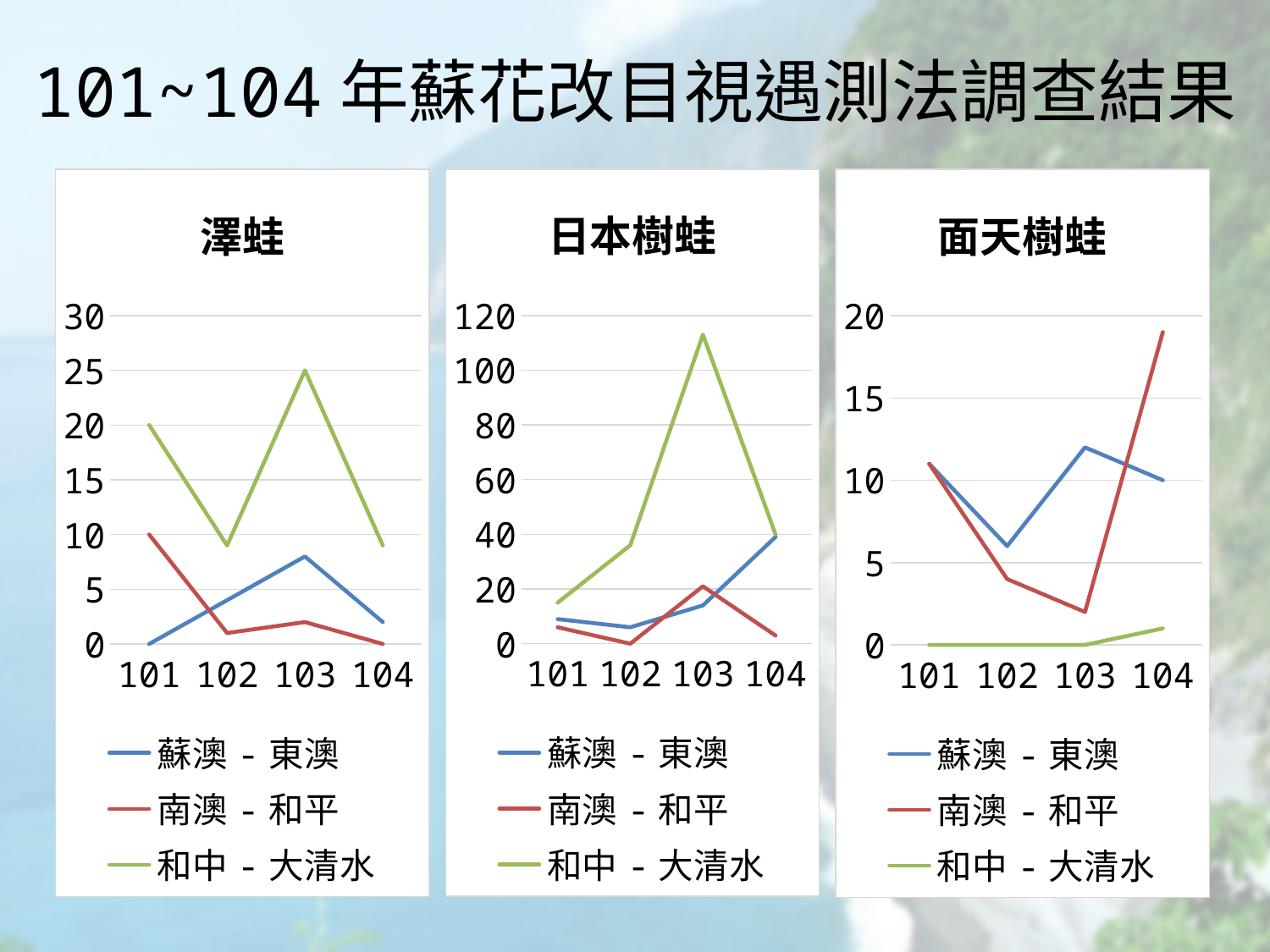
In the 澤蛙 chart, what is the value for 南澳 - 和平 in year 101? 10 What type of chart is the 澤蛙 chart? line chart In the 澤蛙 chart, what is the value for 和中 - 大清水 in year 103? 25 In the 日本樹蛙 chart, which series reaches the highest value? 和中 - 大清水 In the 面天樹蛙 chart, what is the value for 和中 - 大清水 in year 101? 0 In the 日本樹蛙 chart, is the value for 和中 - 大清水 in year 103 greater or less than 100? greater In the 澤蛙 chart, what is the value for 和中 - 大清水 in year 101? 20 In the 面天樹蛙 chart, what is the value for 蘇澳 - 東澳 in year 104? 10 How many series does the legend of the 日本樹蛙 chart list? 3 In the 面天樹蛙 chart, is the value for 南澳 - 和平 in year 104 greater or less than 15? greater In the 澤蛙 chart, which is larger in year 101: 和中 - 大清水 or 南澳 - 和平? 和中 - 大清水 How many years are shown on the x axis of the 面天樹蛙 chart? 4